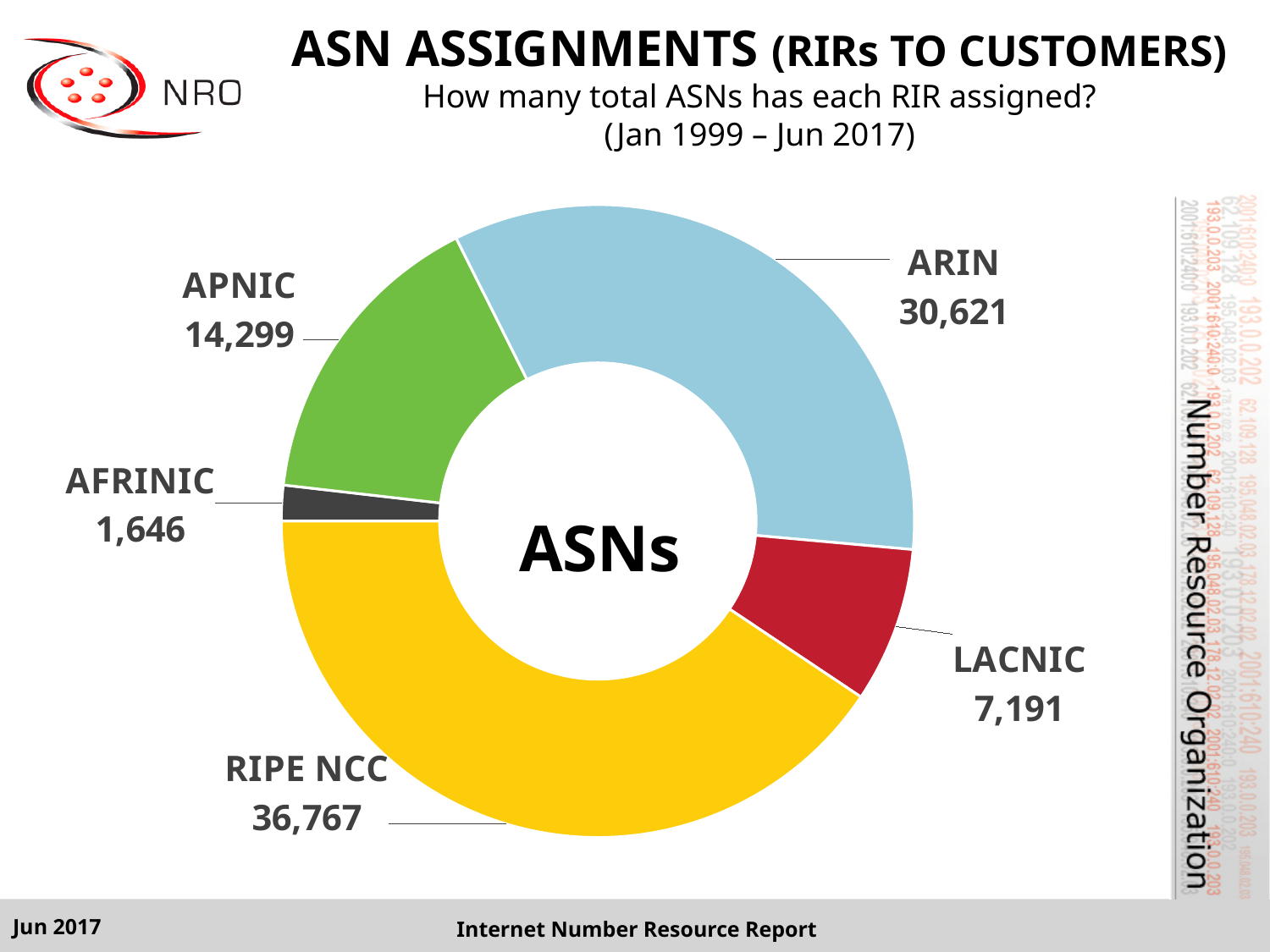
How many ASNs are shown for AFRINIC? 1,646 What text appears in the centre of the donut chart? ASNs What kind of chart is shown on the slide? Pie (donut) chart What value is shown for LACNIC? 7,191 Which RIR has assigned the most ASNs? RIPE NCC How many RIRs are shown in the chart? 5 What is the value shown for RIPE NCC? 36,767 Which RIR has assigned the fewest ASNs? AFRINIC How many ASNs has ARIN assigned according to the chart? 30,621 What is the difference between the ASNs assigned by RIPE NCC and by ARIN? 6,146 Which has assigned more ASNs, APNIC or LACNIC? APNIC How many more ASNs has ARIN assigned than APNIC? 16,322